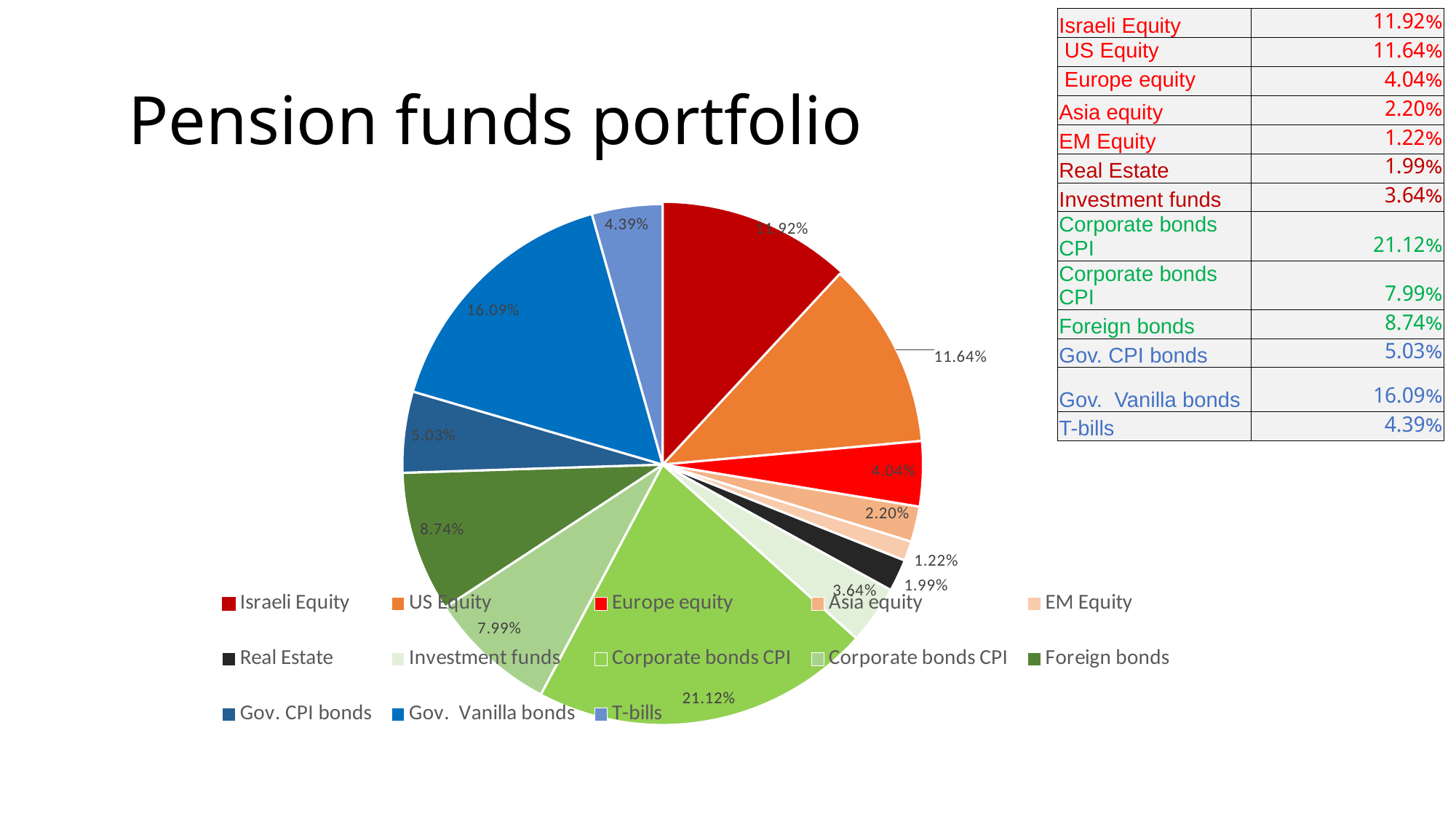
How many entries does the legend of the pie chart list? 13 What is the title of the slide containing the pie chart? Pension funds portfolio What is the value shown for Foreign bonds in the pie chart? 8.74% What is the value shown for US Equity in the pie chart? 11.64% What type of chart is shown on the slide? pie chart What is the difference between the Israeli Equity and US Equity shares in the pie chart? 0.28% What is the value shown for T-bills in the pie chart? 4.39% What is the largest percentage shown on the pie chart? 21.12% What is the value shown for Europe equity in the pie chart? 4.04% What share of the pie does Gov. Vanilla bonds hold? 16.09% Which is larger in the pie chart, Gov. CPI bonds or Gov. Vanilla bonds? Gov. Vanilla bonds Which category has the smallest slice in the pie chart? EM Equity